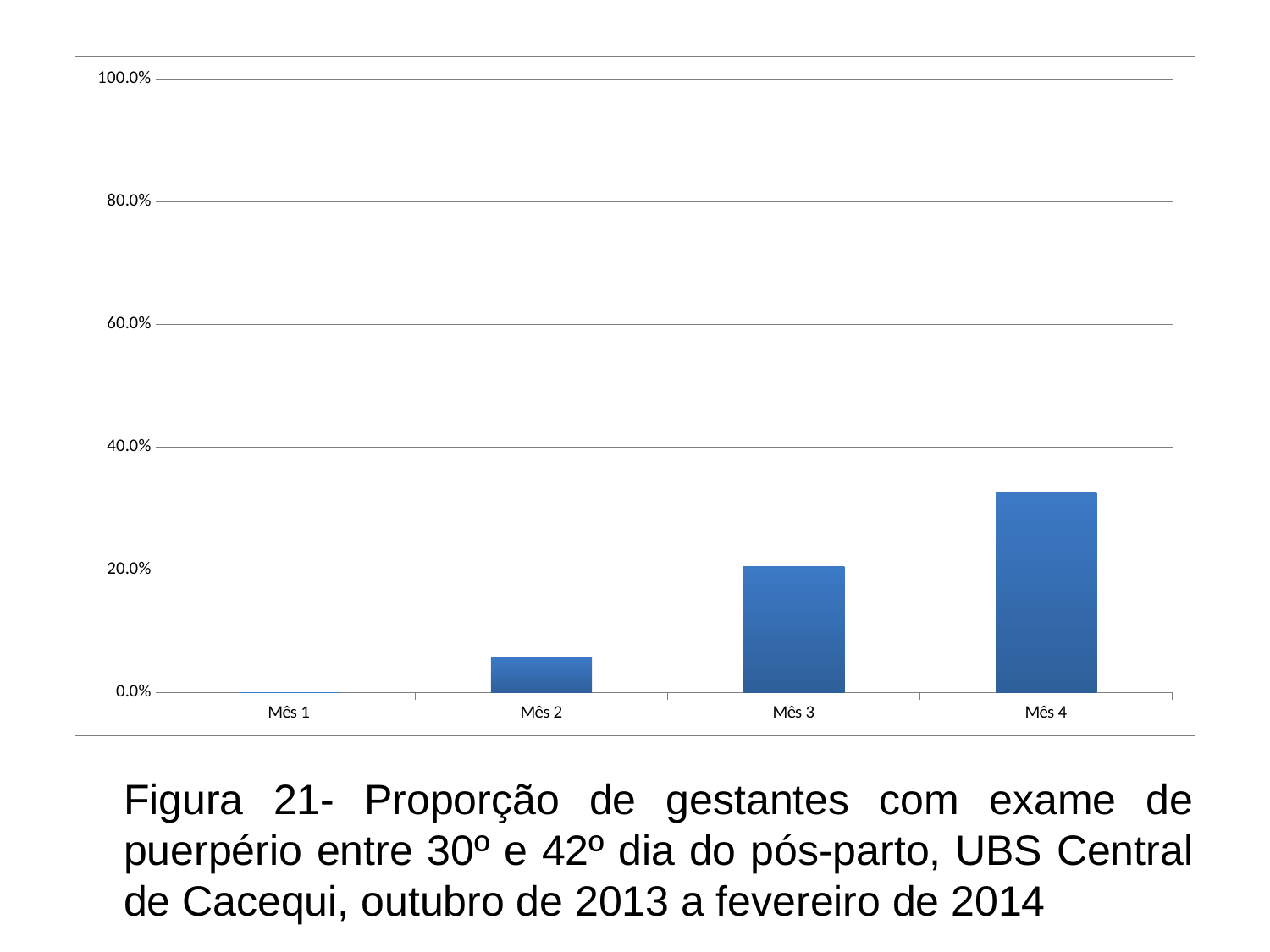
Do the values rise or fall from Mês 1 to Mês 4? rise Which month has the highest proportion in the chart? Mês 4 Is the value for Mês 2 greater or less than 20%? less Is the value for Mês 3 greater or less than 40%? less What is the highest value shown on the y axis of the chart? 100.0% Which is larger, the value for Mês 2 or the value for Mês 4? Mês 4 Which month has the lowest proportion in the chart? Mês 1 Is the value for Mês 4 greater or less than 20%? greater What figure number is given in the caption below the chart? Figura 21 How many months (categories) are shown on the x axis of the chart? 4 What kind of chart is shown on the slide? bar chart